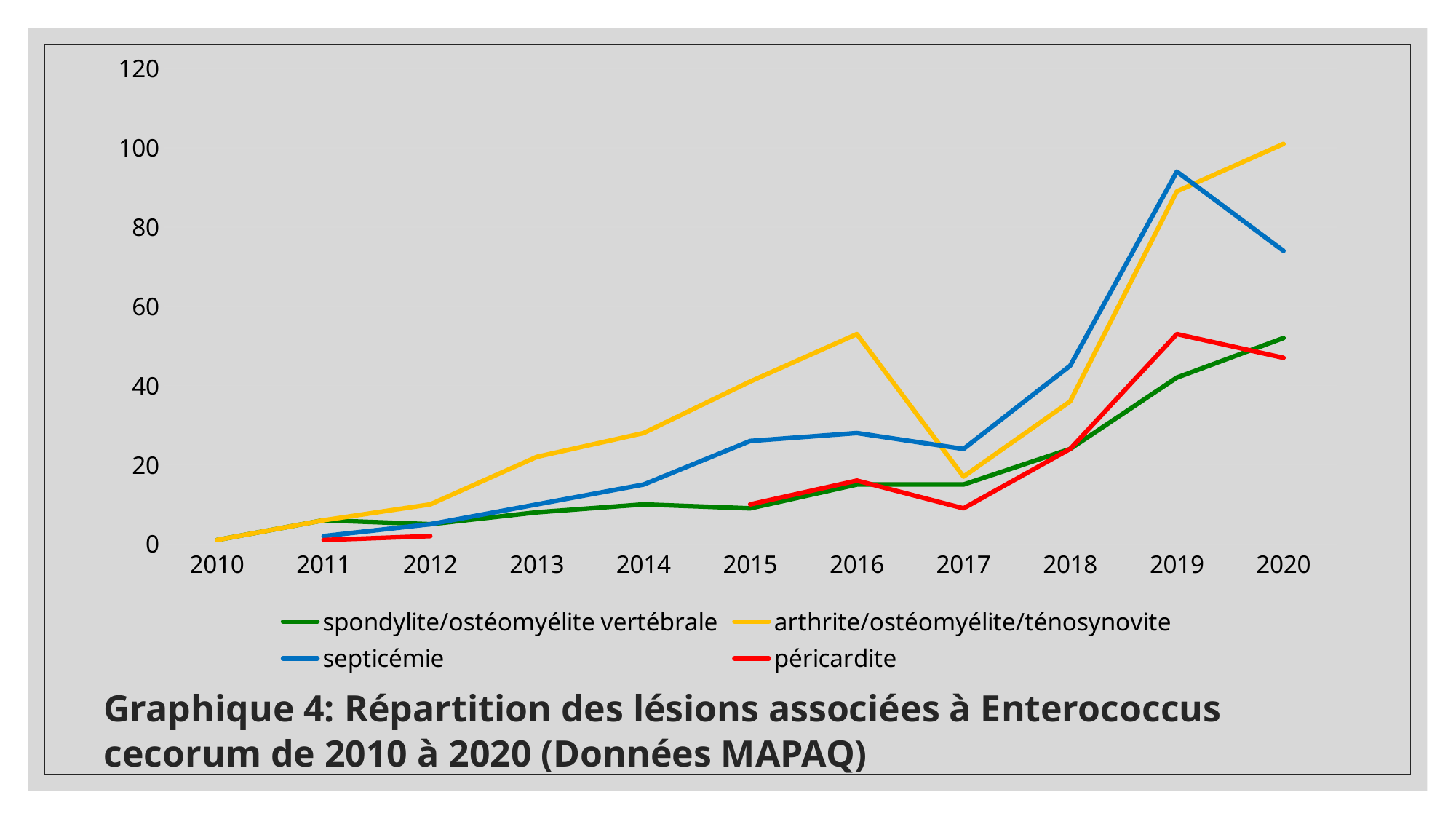
How many years are shown on the x axis? 11 Is the value for arthrite/ostéomyélite/ténosynovite in 2020 greater or less than 80? greater Is the value for arthrite/ostéomyélite/ténosynovite in 2017 greater or less than 20? less In which year does the septicémie series reach its highest value? 2019 What is the title of the chart? Graphique 4: Répartition des lésions associées à Enterococcus cecorum de 2010 à 2020 (Données MAPAQ) Is the value for septicémie in 2019 greater or less than 80? greater In 2016, which is larger: arthrite/ostéomyélite/ténosynovite or septicémie? arthrite/ostéomyélite/ténosynovite What kind of chart is shown on the slide? line chart Which series has the highest value in 2020? arthrite/ostéomyélite/ténosynovite In 2020, which is larger: arthrite/ostéomyélite/ténosynovite or septicémie? arthrite/ostéomyélite/ténosynovite How many series does the legend list? 4